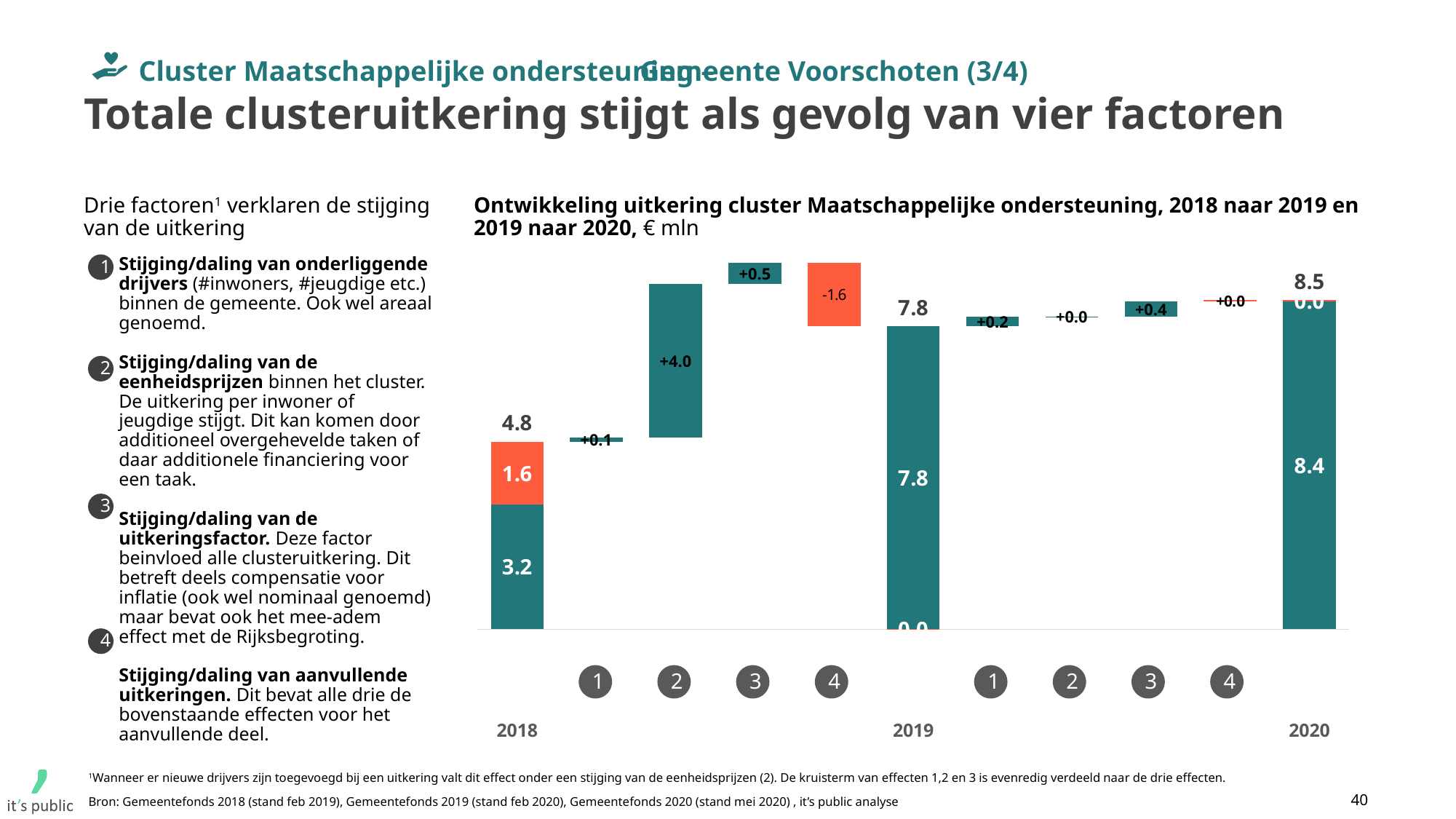
What is the change attributed to factor 3 between 2019 and 2020? +0.4 What is the change attributed to factor 2 between 2018 and 2019? +4.0 What is the total uitkering shown for 2018? 4.8 What is the change attributed to factor 4 between 2018 and 2019? -1.6 What is the total uitkering shown for 2019? 7.8 In what unit are the values in the chart expressed? € mln What is the value of the orange (lower-right) segment of the 2018 bar? 1.6 What is the total uitkering shown for 2020? 8.5 By how much does the total uitkering increase from 2018 to 2020? 3.7 What kind of chart is shown on the slide? Bar chart (waterfall) Which year has the highest total uitkering? 2020 Which factor contributes the largest change between 2018 and 2019? Factor 2 (+4.0)